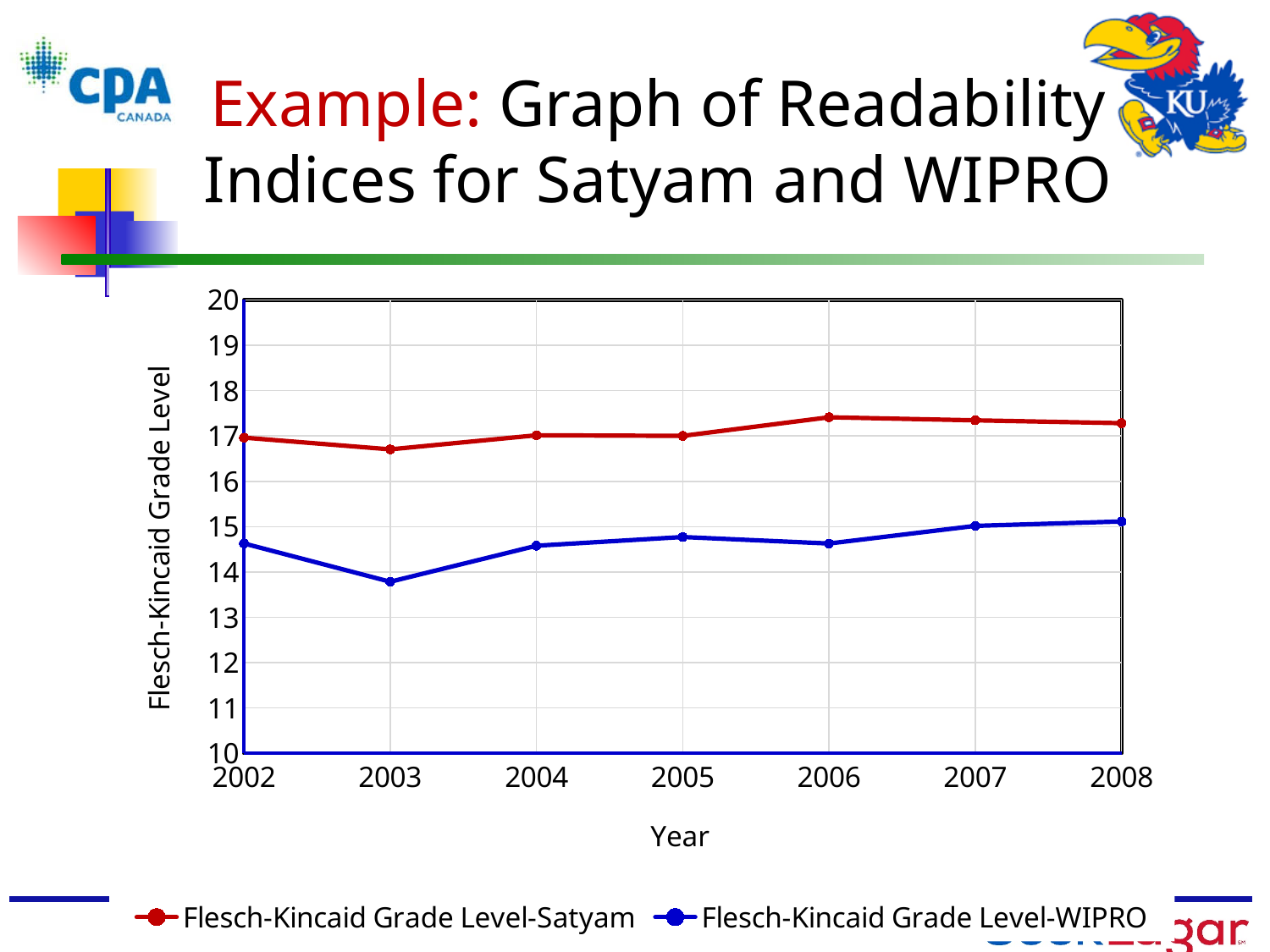
Which series has the higher Flesch-Kincaid Grade Level in 2005, Satyam or WIPRO? Satyam What is the label on the x axis of the chart? Year Is the Flesch-Kincaid Grade Level for Satyam in 2006 greater or less than 17? greater Is the Flesch-Kincaid Grade Level for Satyam in 2003 greater or less than 17? less How many years are plotted along the x axis? 7 How many series does the legend list? 2 Does the Flesch-Kincaid Grade Level for WIPRO rise or fall from 2003 to 2005? rise In which year is the Flesch-Kincaid Grade Level for WIPRO lowest? 2003 Is the Flesch-Kincaid Grade Level for WIPRO in 2002 greater or less than 15? less What kind of chart is shown on the slide? line chart In which year is the Flesch-Kincaid Grade Level for Satyam lowest? 2003